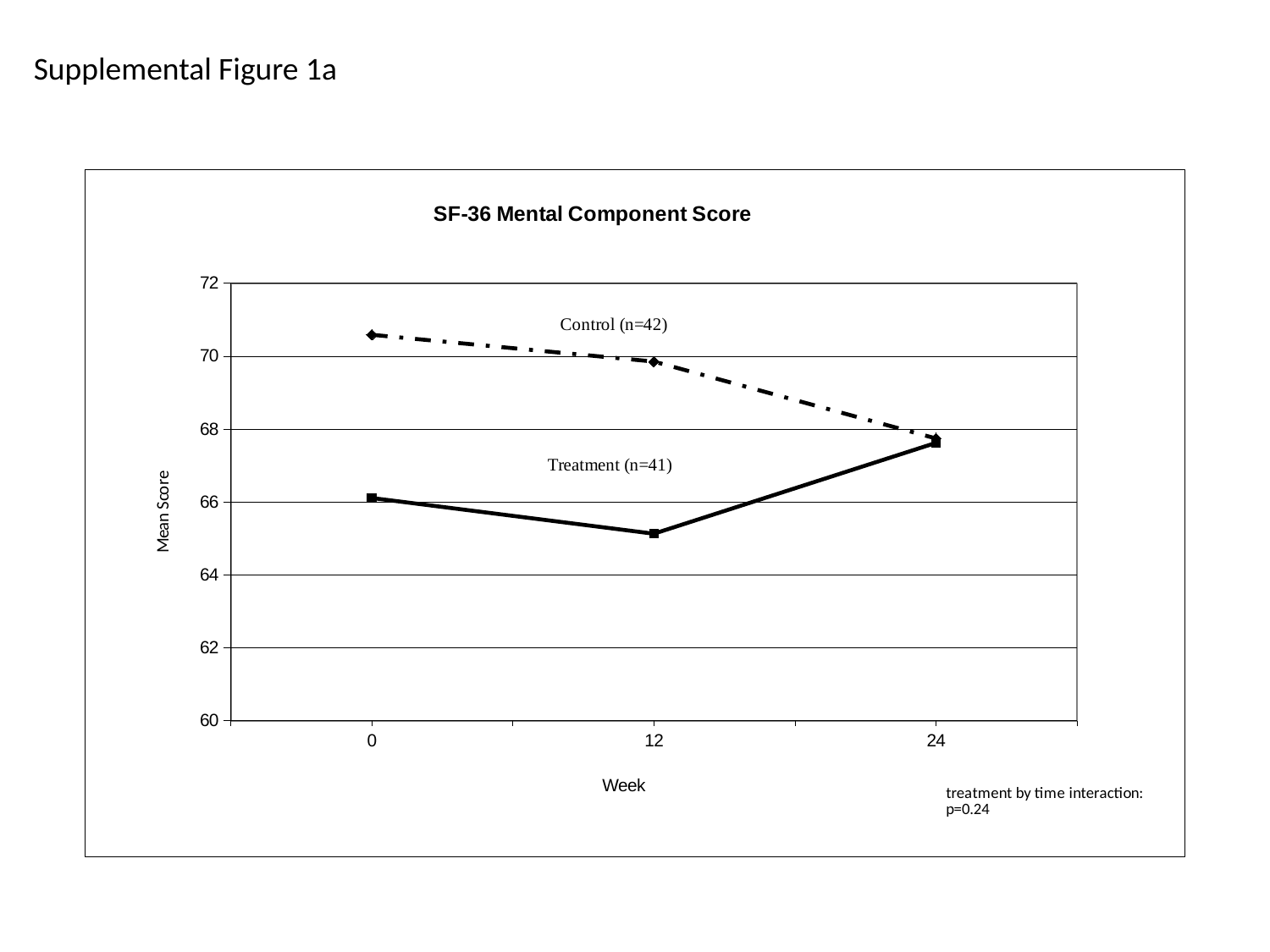
At which week does the Treatment (n=41) series reach its lowest mean score? 12 Is the Control (n=42) value at week 24 greater or less than 68? less What p-value is reported for the treatment by time interaction? p=0.24 What kind of chart is shown on the slide? line chart At week 0, which series has the higher mean score, Control (n=42) or Treatment (n=41)? Control (n=42) How many time points (weeks) are plotted along the x axis? 3 Is the Control (n=42) value at week 0 greater or less than 70? greater What is the title of the chart? SF-36 Mental Component Score How many series are plotted on the chart? 2 Is the Treatment (n=41) value at week 12 greater or less than 66? less Does the Control (n=42) line rise or fall from week 0 to week 24? fall